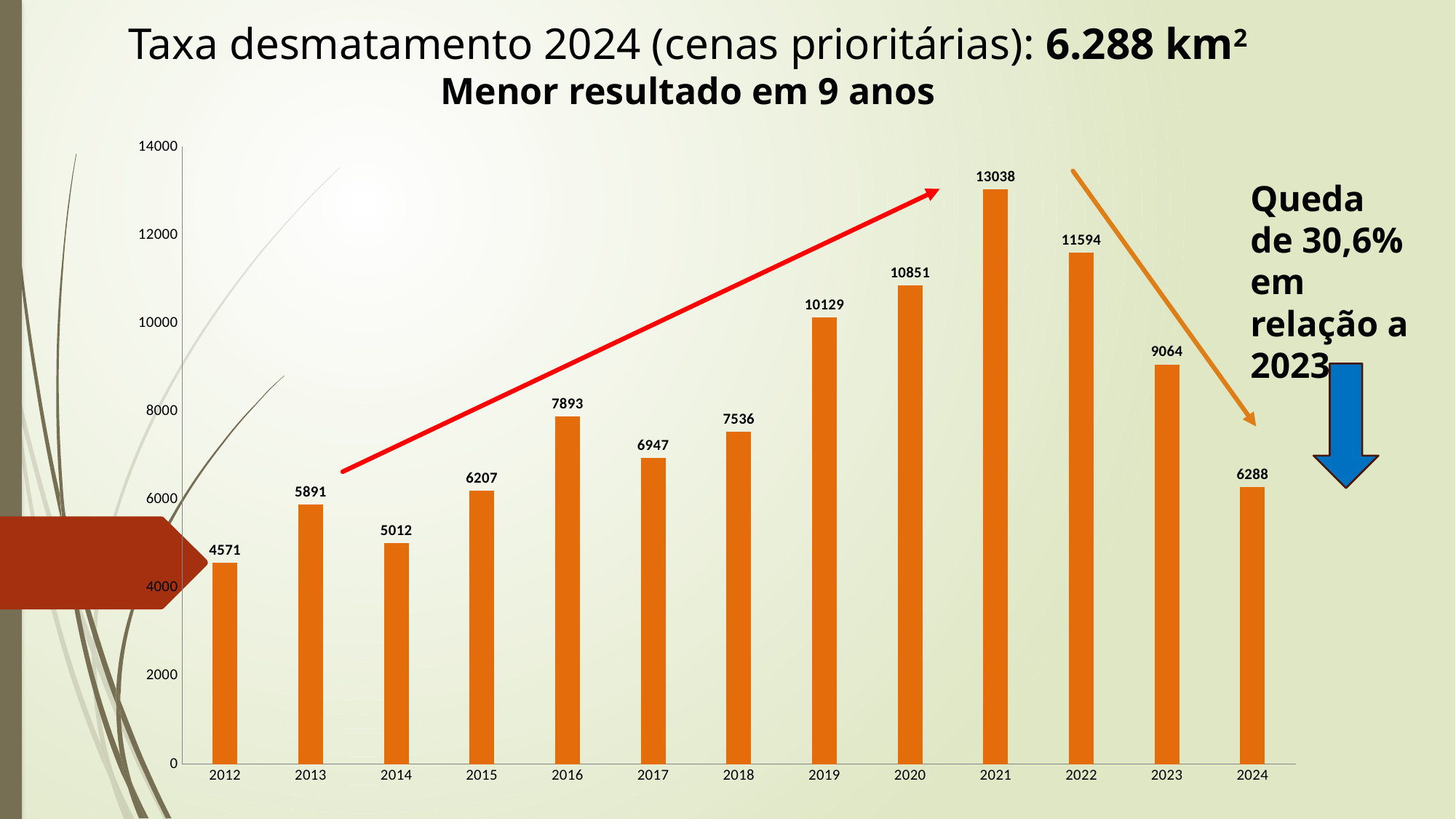
Is the value for 2020 greater or less than 10000? greater What is the difference between the values for 2023 and 2024? 2776 Which is larger, the value for 2017 or the value for 2018? 2018 Which year has the lowest value? 2012 How many years are shown on the x axis? 13 What is the difference between the values for 2021 and 2022? 1444 What is the value for 2016? 7893 Which year has the highest value? 2021 Do the values rise or fall from 2021 to 2024? fall What is the value for 2024? 6288 What is the value for 2021? 13038 What kind of chart is shown on the slide? bar chart